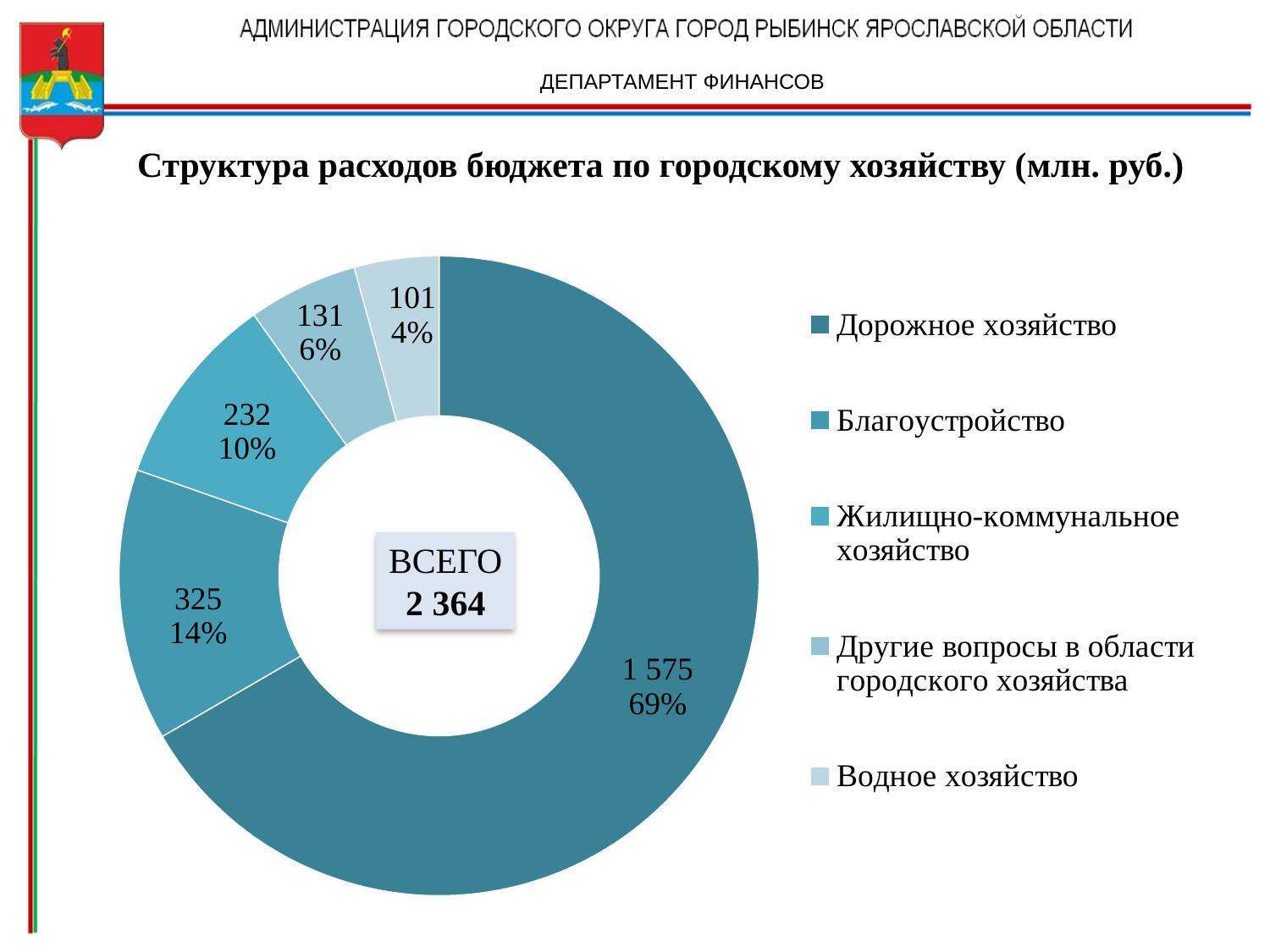
Which category has the largest value? Дорожное хозяйство Which is larger, the value for Другие вопросы в области городского хозяйства or the value for Водное хозяйство? Другие вопросы в области городского хозяйства What share of the total does Другие вопросы в области городского хозяйства represent? 6% What share of the total does Дорожное хозяйство represent? 69% What type of chart is shown on the slide? doughnut (pie) chart What is the value for Водное хозяйство? 101 What is the value for Дорожное хозяйство? 1 575 What is the value for Жилищно-коммунальное хозяйство? 232 Which category has the smallest value? Водное хозяйство How many categories does the chart show? 5 What is the value for Благоустройство? 325 What is the difference between the values for Благоустройство and Жилищно-коммунальное хозяйство? 93